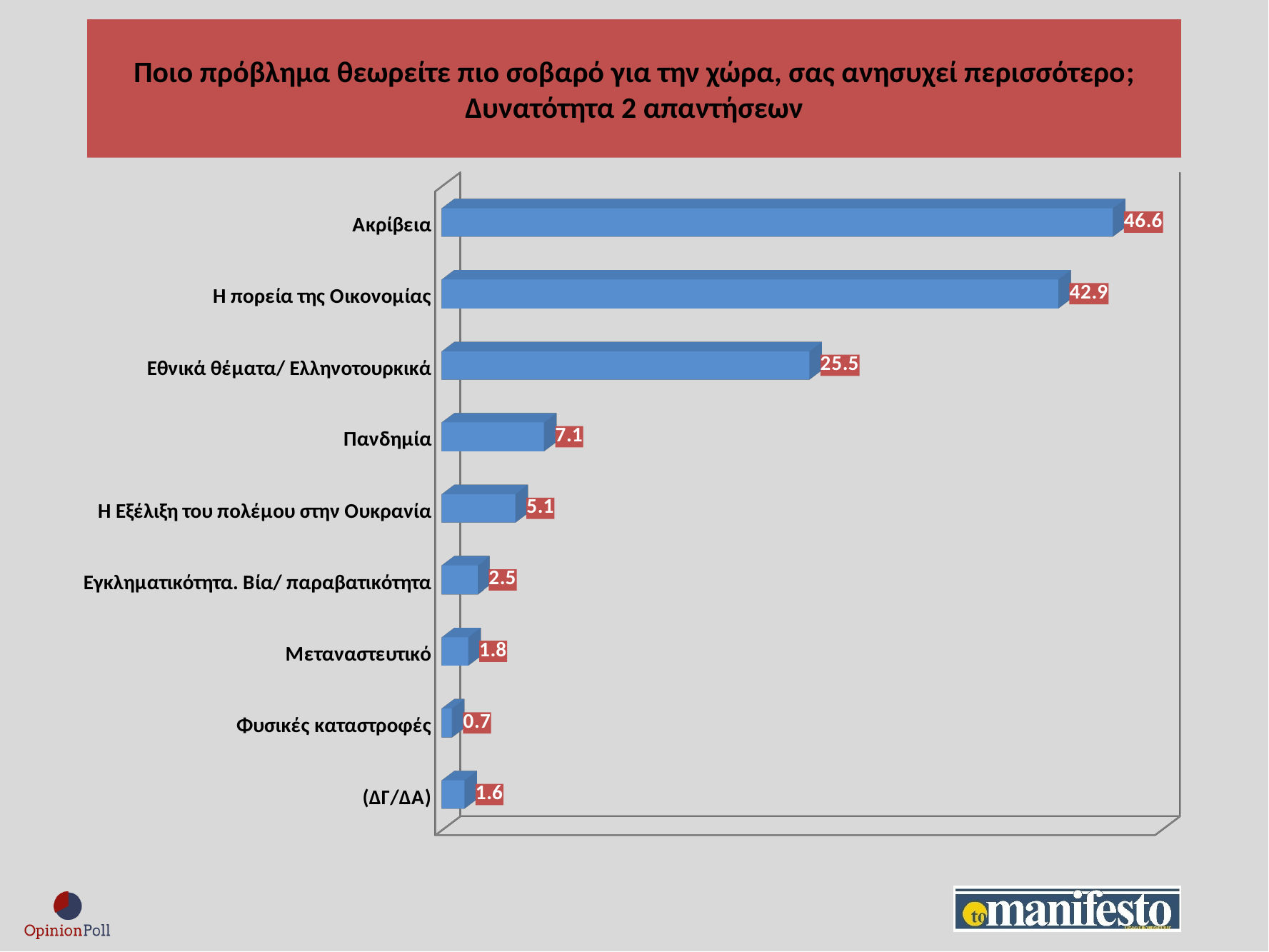
Which category has the lowest value? Φυσικές καταστροφές Which is larger, the value for Η Εξέλιξη του πολέμου στην Ουκρανία or the value for Εγκληματικότητα. Βία/ παραβατικότητα? Η Εξέλιξη του πολέμου στην Ουκρανία What kind of chart is shown on the slide? Bar chart What is the difference between the values for Εθνικά θέματα/ Ελληνοτουρκικά and Πανδημία? 18.4 Which is larger, the value for Μεταναστευτικό or the value for (ΔΓ/ΔΑ)? Μεταναστευτικό Which category has the highest value? Ακρίβεια What value is shown for Ακρίβεια? 46.6 What value is shown for Φυσικές καταστροφές? 0.7 What value is shown for Η πορεία της Οικονομίας? 42.9 How many categories are shown in the chart? 9 What is the difference between the values for Ακρίβεια and Η πορεία της Οικονομίας? 3.7 What value is shown for Πανδημία? 7.1